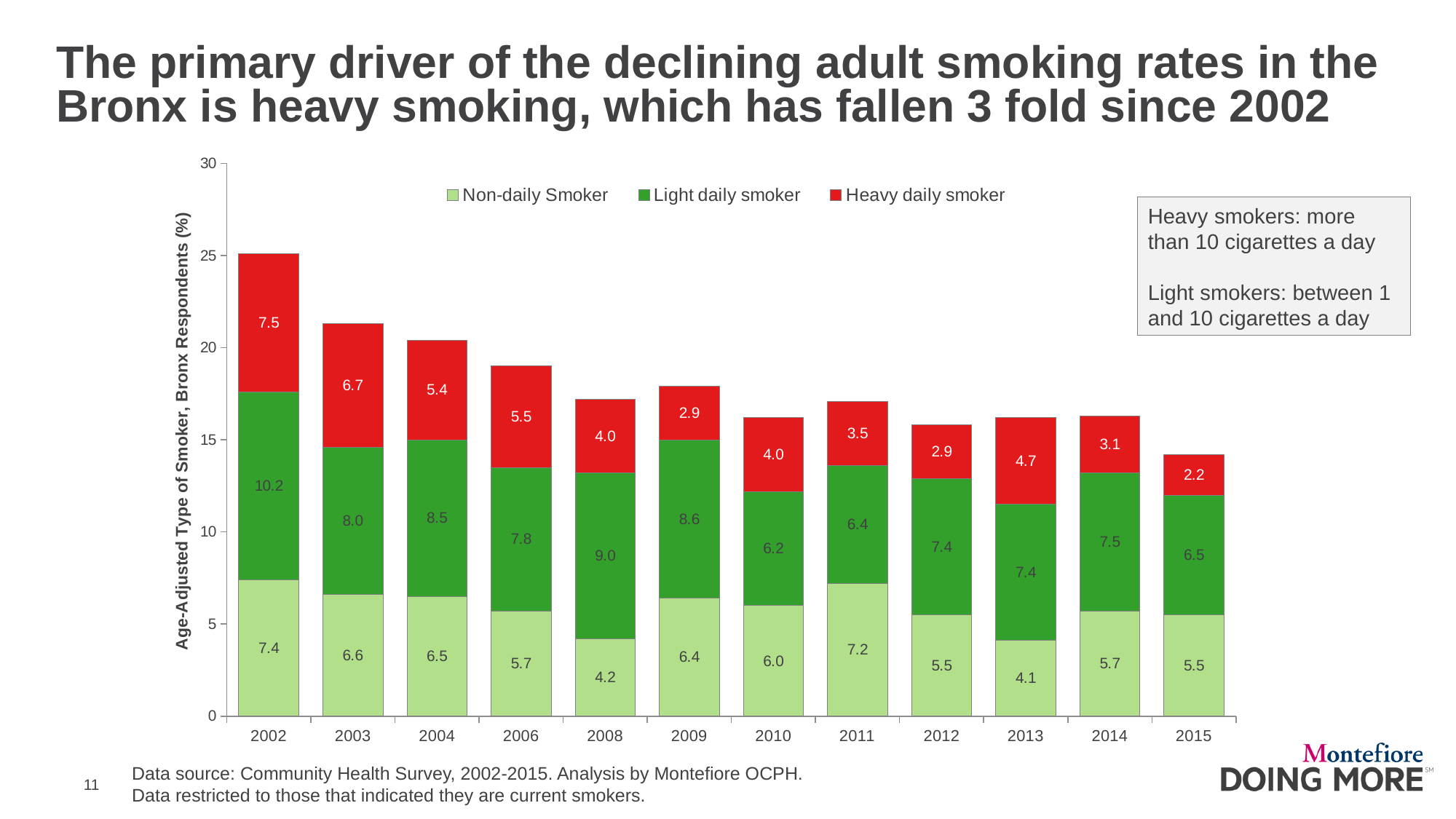
What is the difference between the Heavy daily smoker values in 2002 and 2015? 5.3 What is the value for Heavy daily smoker in 2002? 7.5 Which is larger, the Non-daily Smoker value in 2011 or in 2012? 2011 What is the value for Light daily smoker in 2008? 9.0 What is the value for Non-daily Smoker in 2013? 4.1 What type of chart is shown on the slide? Stacked bar chart How many series does the legend list? 3 How many years are shown on the x axis? 12 Does the total height of the stacked bars generally rise or fall from 2002 to 2015? Fall In which year is the Heavy daily smoker value lowest? 2015 In which year is the Light daily smoker value highest? 2002 What is the total of the stacked bar for 2015? 14.2